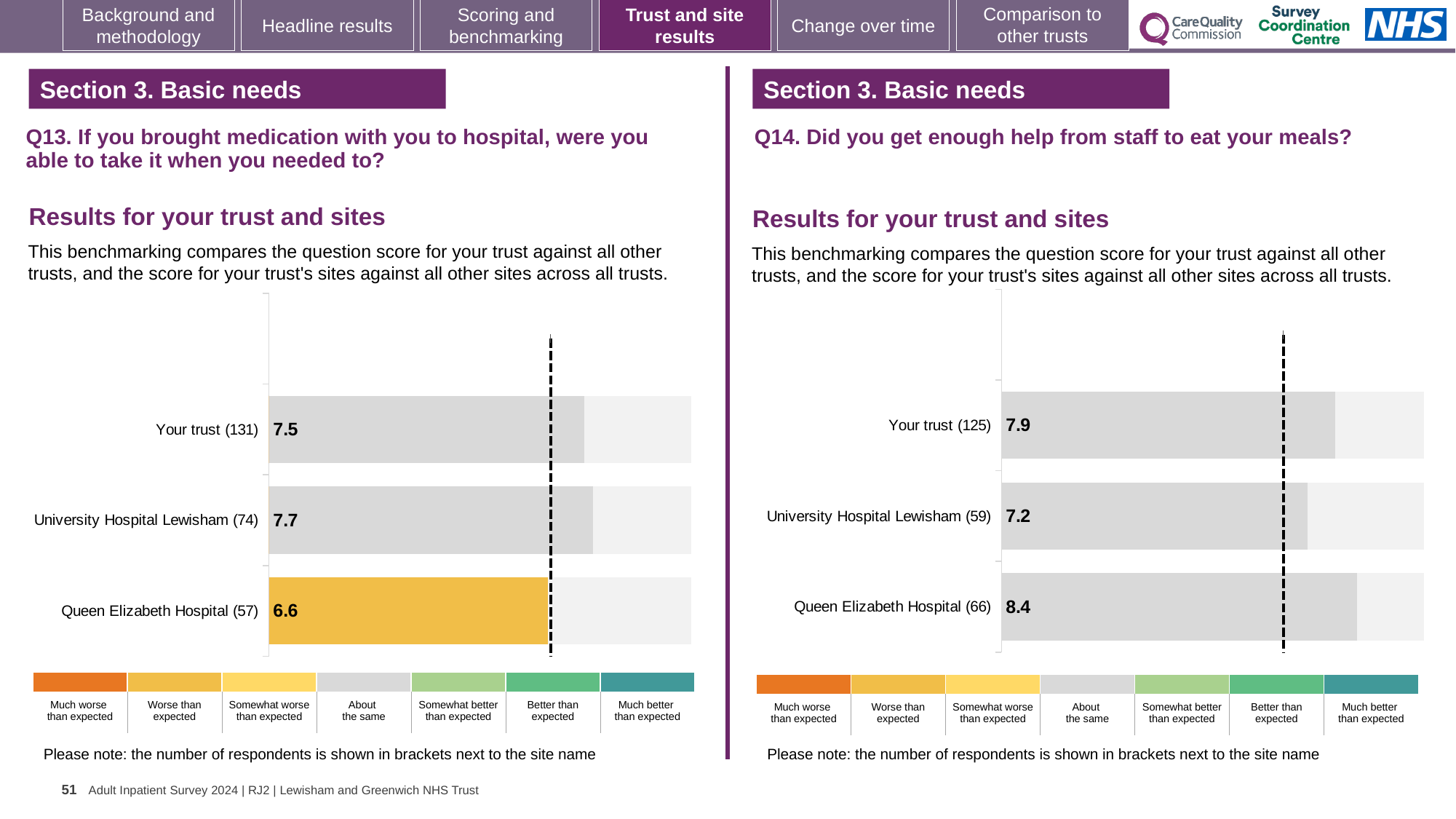
In the Q13 chart on the left, what is the difference between the scores for University Hospital Lewisham and Queen Elizabeth Hospital? 1.1 In the Q13 chart on the left, what is the score for Queen Elizabeth Hospital? 6.6 In the Q14 chart on the right, is the score for Queen Elizabeth Hospital larger or smaller than the score for Your trust? larger In the Q13 chart on the left, what is the score for Your trust? 7.5 What type of chart is used for the Q14 results on the right? Bar chart In the Q13 chart on the left, which site or trust has the highest score? University Hospital Lewisham How many bars are plotted in the Q13 chart on the left? 3 In the Q13 chart on the left, how many respondents are shown for Queen Elizabeth Hospital? 57 In the Q14 chart on the right, what is the difference between the scores for Queen Elizabeth Hospital and Your trust? 0.5 In the Q14 chart on the right, what is the score for University Hospital Lewisham? 7.2 In the Q14 chart on the right, what is the score for Queen Elizabeth Hospital? 8.4 In the Q14 chart on the right, which site or trust has the lowest score? University Hospital Lewisham